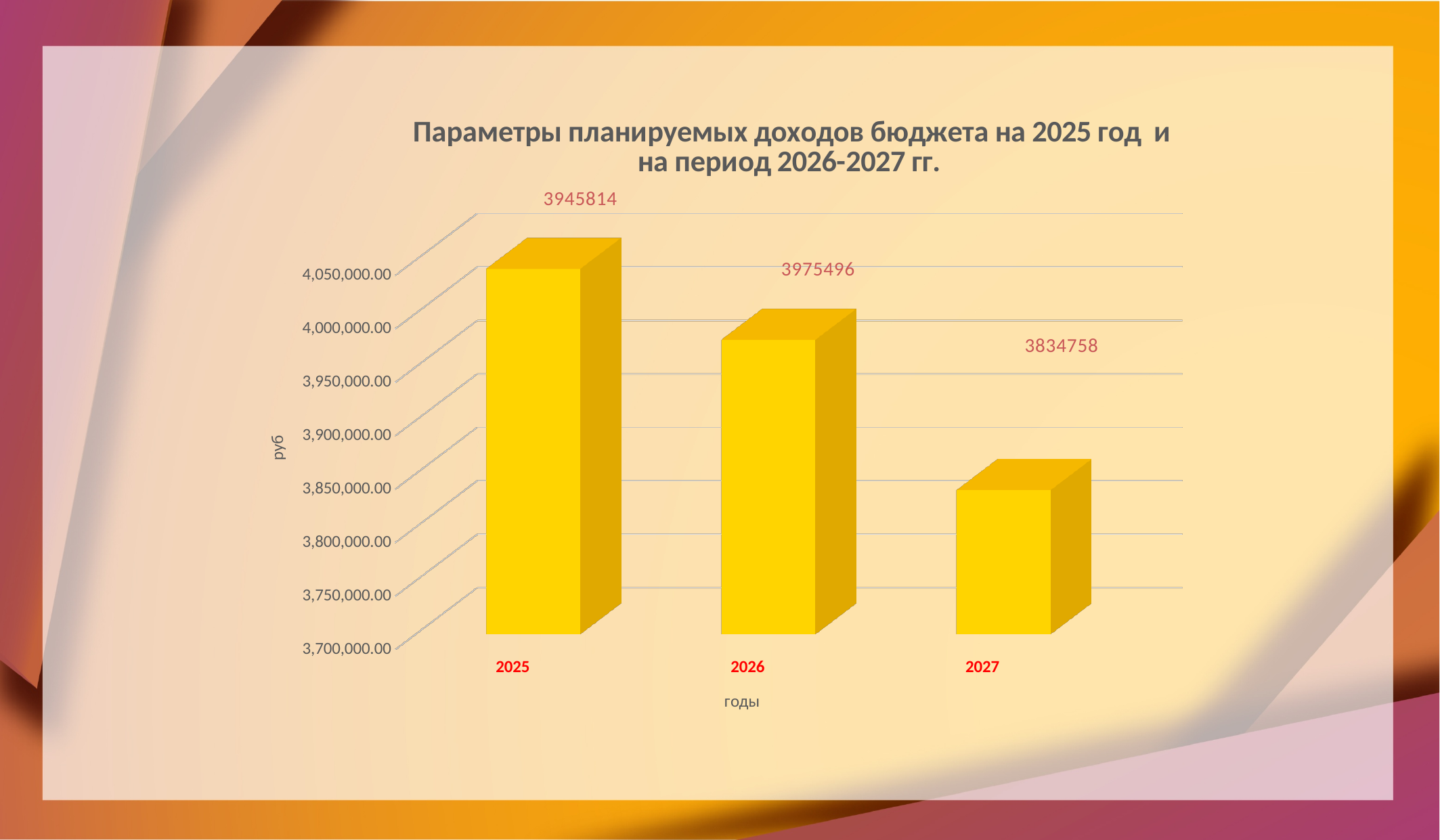
What is the data label shown for 2025? 3945814 What is the data label shown for 2027? 3834758 Is the value for 2027 greater or less than 3,850,000.00? less What is the label of the vertical axis? руб What kind of chart is shown on the slide? bar chart What is the data label shown for 2026? 3975496 Which is larger, the value for 2026 or the value for 2027? 2026 What is the difference between the labelled values for 2026 and 2027? 140738 Is the value for 2026 greater or less than 4,000,000.00? less How many years are shown on the x axis? 3 Which year has the lowest value? 2027 What is the difference between the labelled values for 2025 and 2027? 111056